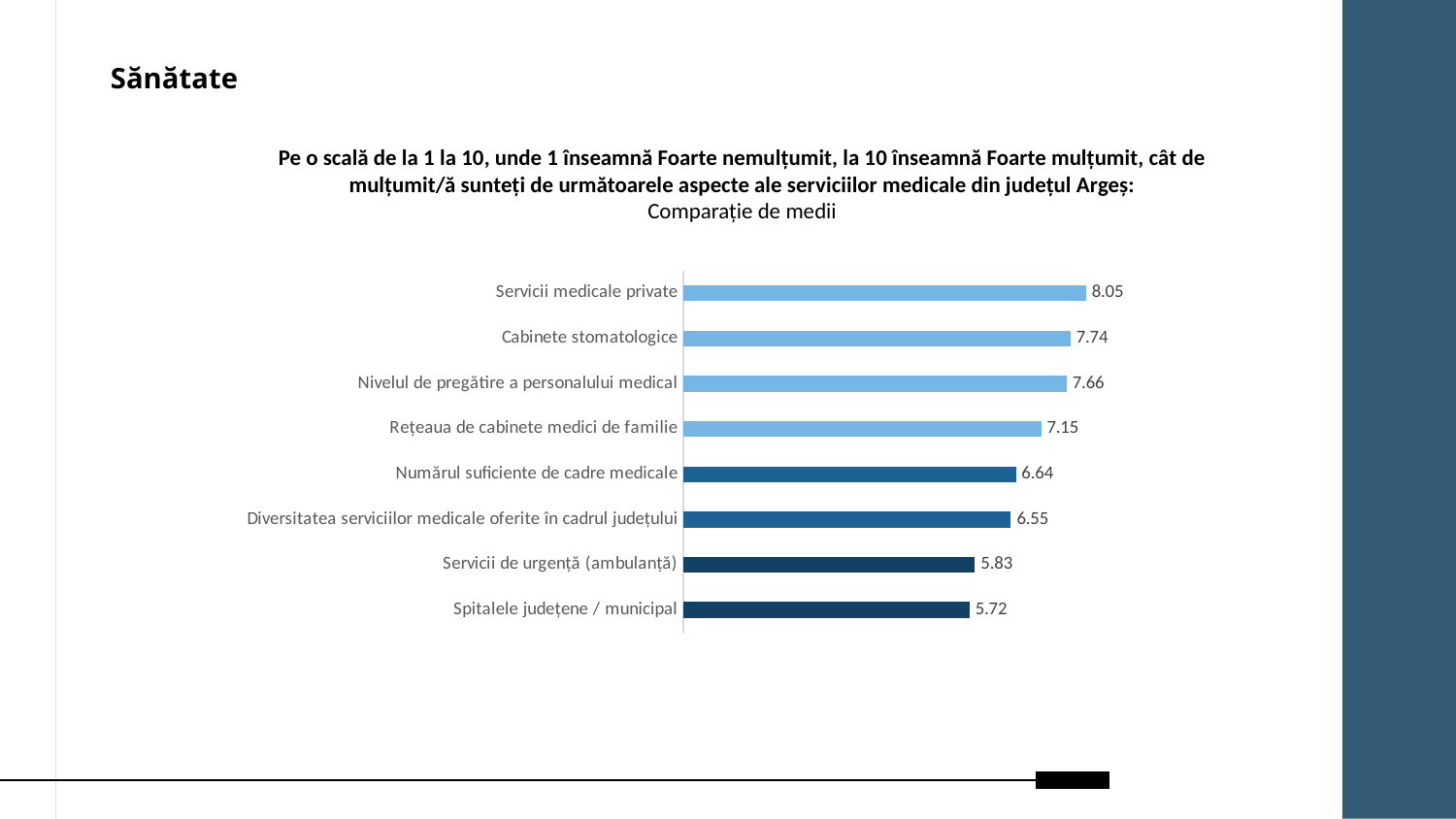
How many aspects are shown in the chart? 8 What is the average score for Spitalele județene / municipal? 5.72 Which aspect has the highest average score? Servicii medicale private What is the difference between the scores for Cabinete stomatologice and Nivelul de pregătire a personalului medical? 0.08 How many bars are shown in the lighter blue colour? 4 What is the average score for Servicii de urgență (ambulanță)? 5.83 What is the average score for Rețeaua de cabinete medici de familie? 7.15 What is the average score for Servicii medicale private? 8.05 What type of chart is shown on the slide? Bar chart Which has a higher score: Numărul suficiente de cadre medicale or Rețeaua de cabinete medici de familie? Rețeaua de cabinete medici de familie What is the difference between the scores for Servicii medicale private and Spitalele județene / municipal? 2.33 Which aspect has the lowest average score? Spitalele județene / municipal